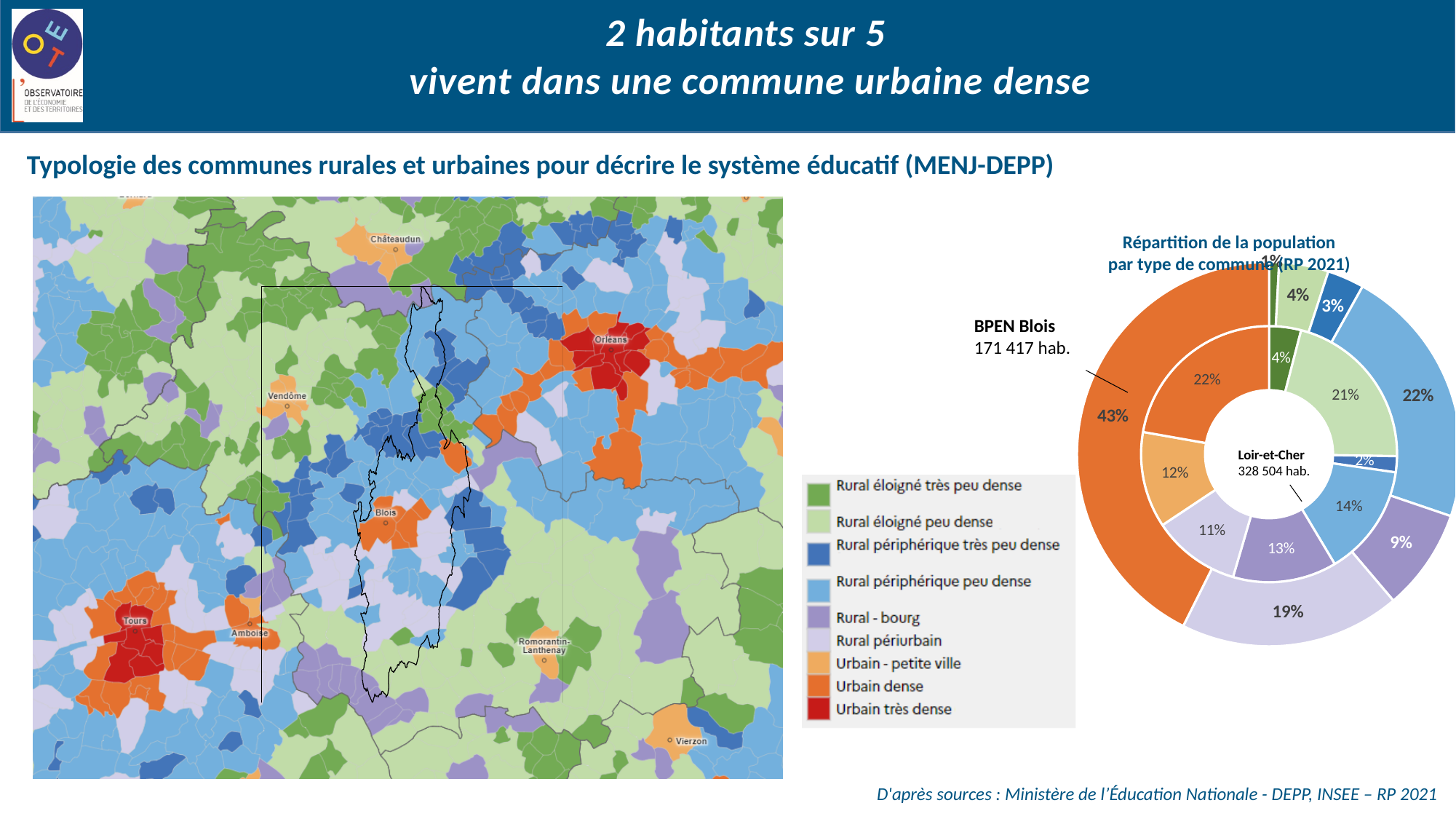
What kind of chart is the 'Répartition de la population par type de commune (RP 2021)' chart? doughnut chart How many commune types does the legend on the slide list? 9 In the doughnut chart, what share of the BPEN Blois population (outer ring) is in the light purple 'Rural périurbain' category? 19% In the doughnut chart, what share of the Loir-et-Cher population (inner ring) is in the purple 'Rural - bourg' category? 13% In the doughnut chart, what is the population figure given for Loir-et-Cher? 328 504 hab. In the doughnut chart, which has the larger 'Rural éloigné peu dense' (light green) share: Loir-et-Cher or BPEN Blois? Loir-et-Cher In the doughnut chart, by how many percentage points does the 'Urbain dense' share for BPEN Blois (43%) exceed that for Loir-et-Cher (22%)? 21 percentage points In the doughnut chart, what is the smallest share shown in the inner ring (Loir-et-Cher)? 2% In the doughnut chart, what is the smallest share shown in the outer ring (BPEN Blois)? 1% In the doughnut chart, what is the largest share shown in the inner ring (Loir-et-Cher)? 22% In the doughnut chart, what is the population figure given for BPEN Blois? 171 417 hab. In the doughnut chart, what is the largest share shown in the outer ring (BPEN Blois)? 43%